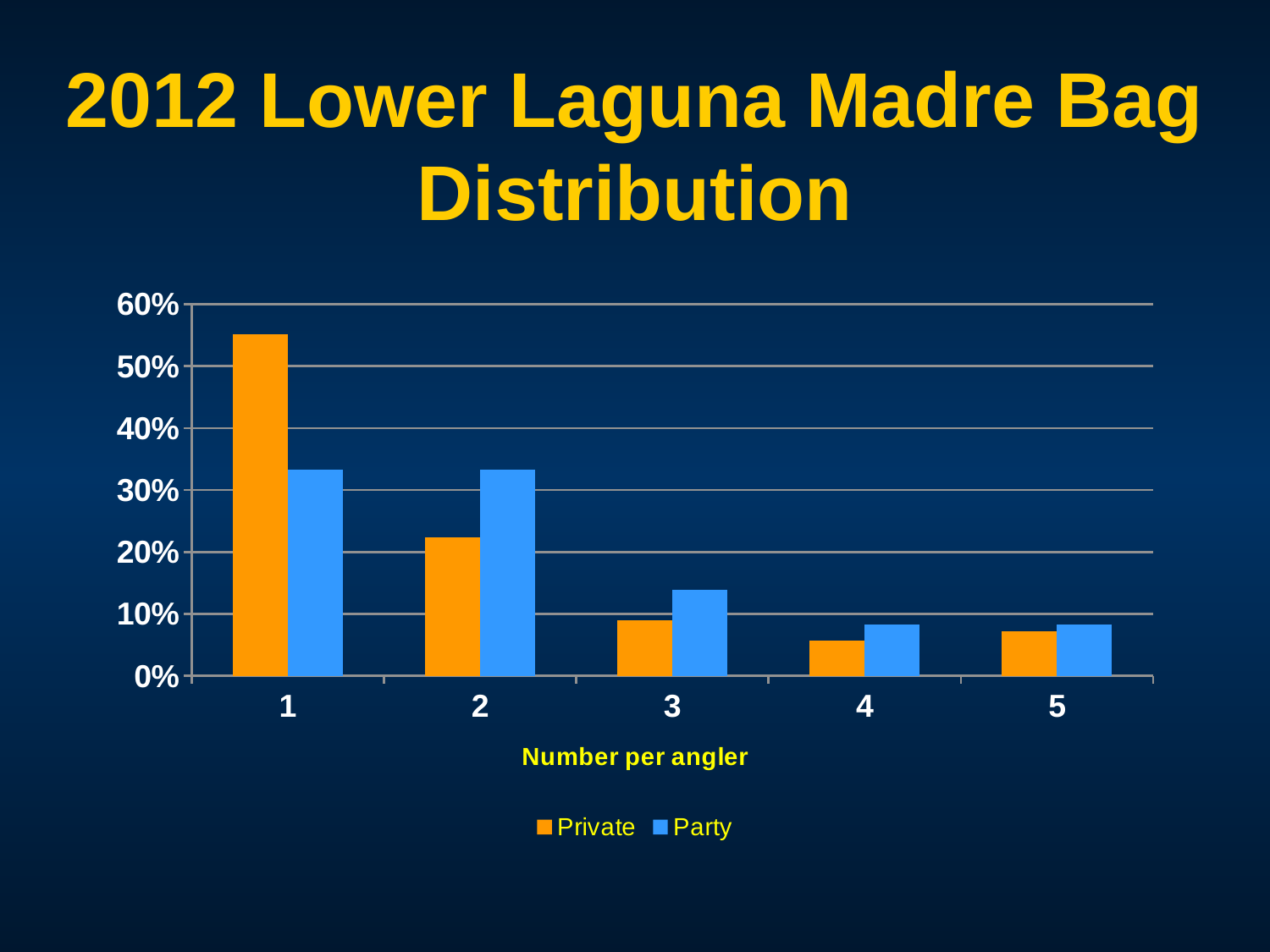
At number per angler 1, which series is larger, Private or Party? Private Is the Private value for number per angler 1 greater or less than 50%? greater Is the Private value for number per angler 3 greater or less than 10%? less What is the title of the x axis? Number per angler How many series does the legend list? 2 At number per angler 3, which series is larger, Private or Party? Party Does the Private series generally rise or fall as the number per angler increases from 1 to 4? fall At number per angler 2, which series is larger, Private or Party? Party For which number per angler is the Private series highest? 1 How many categories are shown on the x axis? 5 What kind of chart is shown on the slide? bar chart Is the Party value for number per angler 3 greater or less than 10%? greater